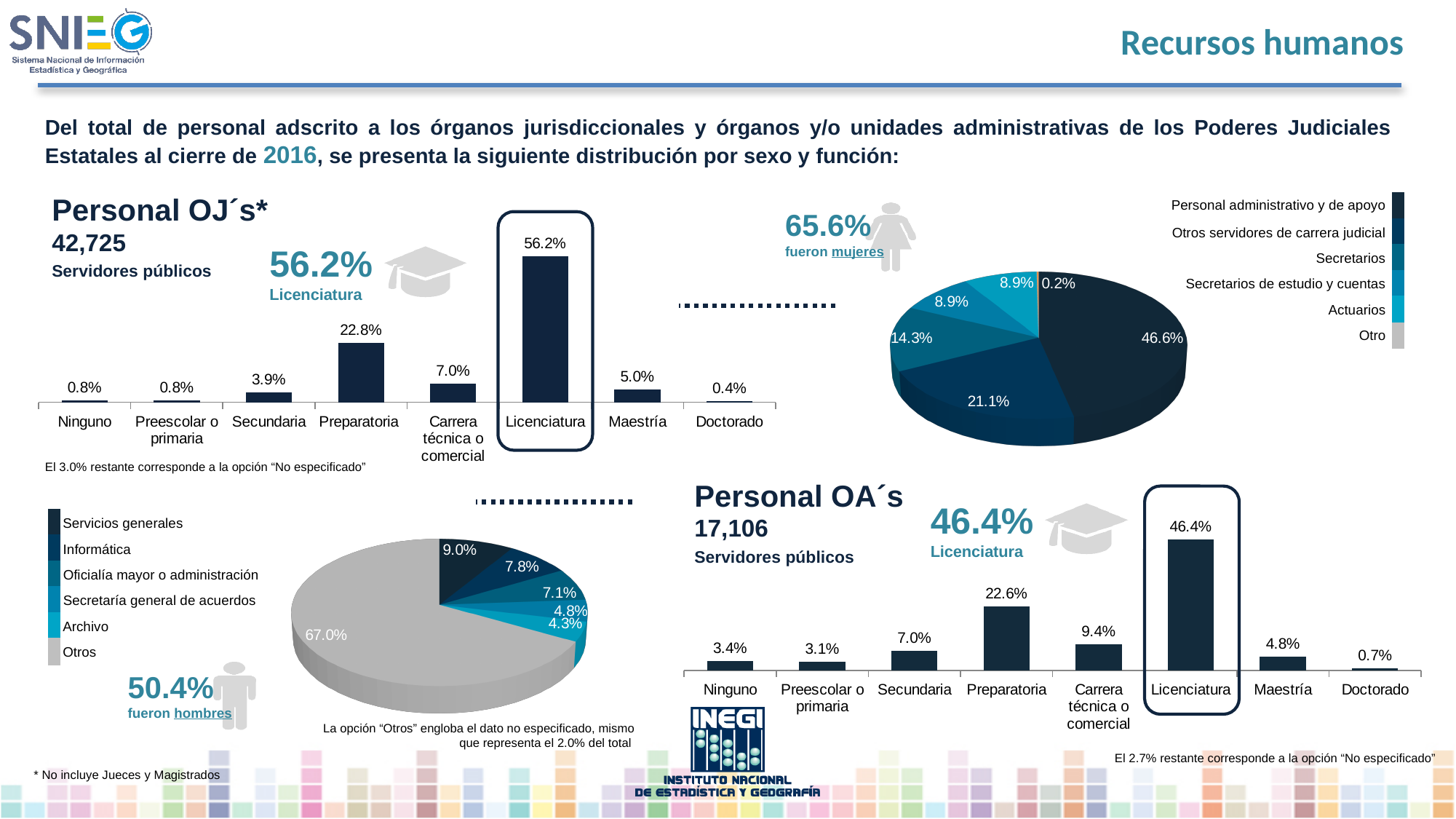
How many categories does the Personal OA's bar chart show? 8 In the pie chart in the lower left of the slide, what share corresponds to Otros? 67.0% In the Personal OJ's bar chart, which category has the lowest value? Doctorado In the Personal OA's bar chart, what is the difference between Licenciatura and Doctorado? 45.7% How many entries does the legend of the lower-left pie chart list? 6 In the Personal OA's bar chart, which is larger, Secundaria or Maestría? Secundaria In the Personal OJ's bar chart, which category has the highest value? Licenciatura In the Personal OA's bar chart, what is the value for Carrera técnica o comercial? 9.4% In the pie chart next to Personal OJ's, what share corresponds to Personal administrativo y de apoyo? 46.6% In the pie chart next to Personal OJ's, what share corresponds to Otros servidores de carrera judicial? 21.1% In the Personal OJ's bar chart, what is the value for Preparatoria? 22.8% In the Personal OJ's bar chart, what is the difference between Licenciatura and Preparatoria? 33.4%